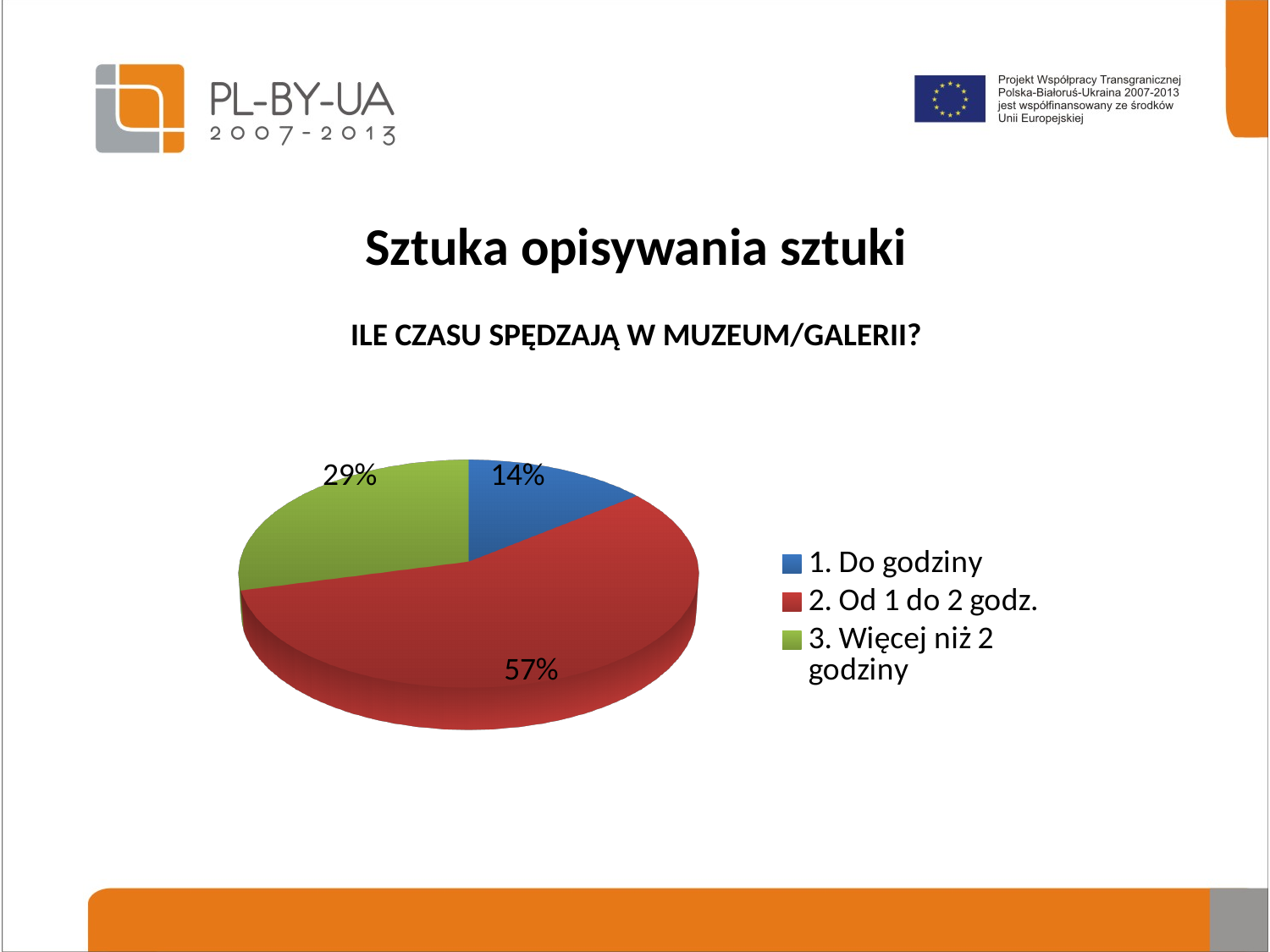
What share of the pie does "3. Więcej niż 2 godziny" represent? 29% What kind of chart is shown on the slide? pie chart How many categories does the pie chart have? 3 What is the difference between the shares for "3. Więcej niż 2 godziny" and "1. Do godziny"? 15% What share of the pie does "1. Do godziny" represent? 14% Which category has the largest slice of the pie? 2. Od 1 do 2 godz. What is the title of the chart? ILE CZASU SPĘDZAJĄ W MUZEUM/GALERII? Which is larger: the share for "1. Do godziny" or the share for "3. Więcej niż 2 godziny"? 3. Więcej niż 2 godziny What colour is the slice for "2. Od 1 do 2 godz."? red What is the difference between the shares for "2. Od 1 do 2 godz." and "3. Więcej niż 2 godziny"? 28% Which category has the smallest slice of the pie? 1. Do godziny What share of the pie does "2. Od 1 do 2 godz." represent? 57%